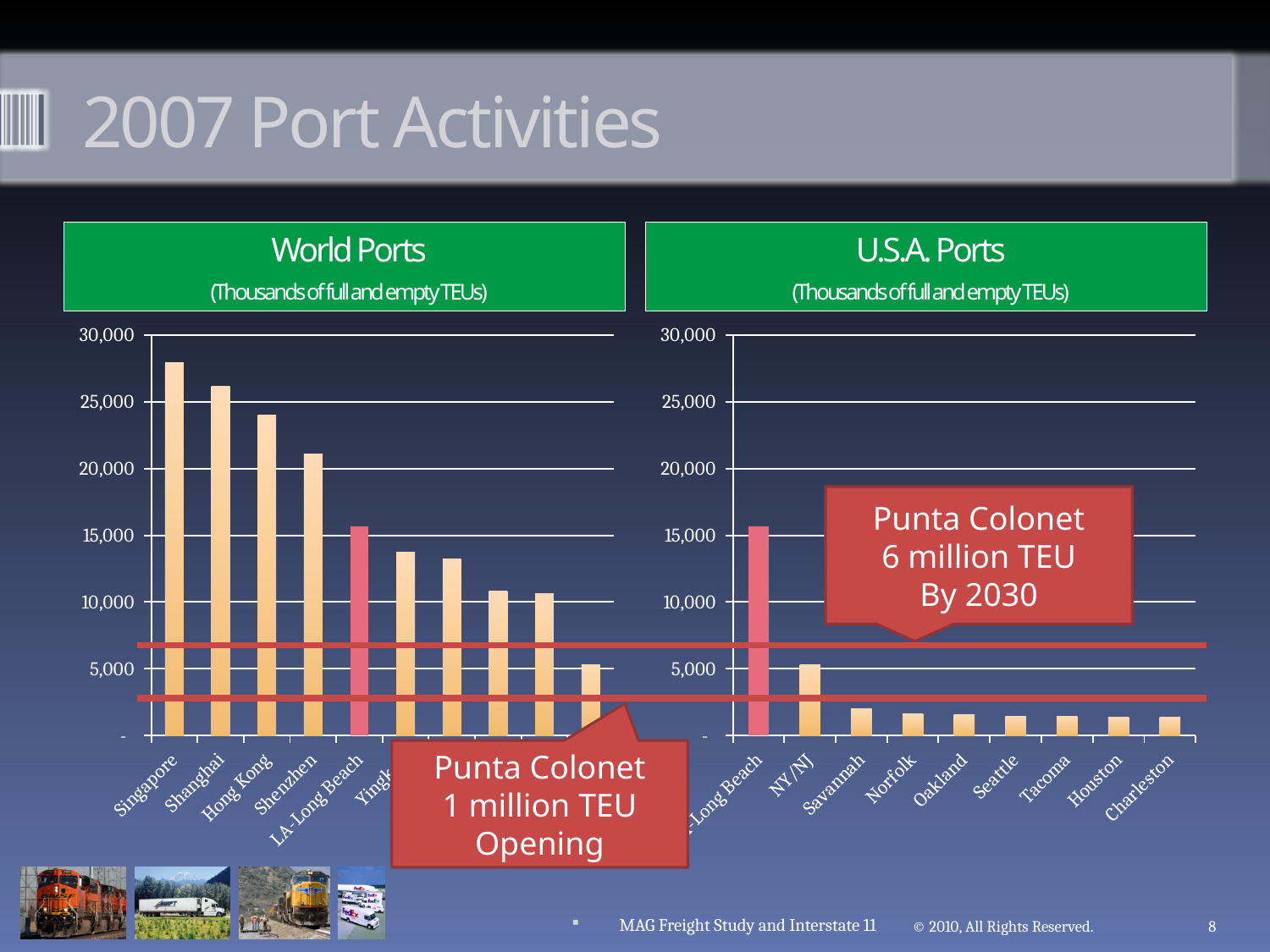
In the World Ports chart, is the value for Singapore greater or less than 25,000? greater In the U.S.A. Ports chart, which is larger, NY/NJ or Norfolk? NY/NJ In the U.S.A. Ports chart, is the value for NY/NJ greater or less than 10,000? less What unit is given in the subtitle of the U.S.A. Ports chart? Thousands of full and empty TEUs In the World Ports chart, is the value for Hong Kong greater or less than 25,000? less How many ports are shown in the U.S.A. Ports chart? 9 What kind of chart is the World Ports chart? bar chart In the World Ports chart, do the values rise or fall from left to right? fall In the World Ports chart, which is larger, Shanghai or Hong Kong? Shanghai In the World Ports chart, which port has the highest value? Singapore